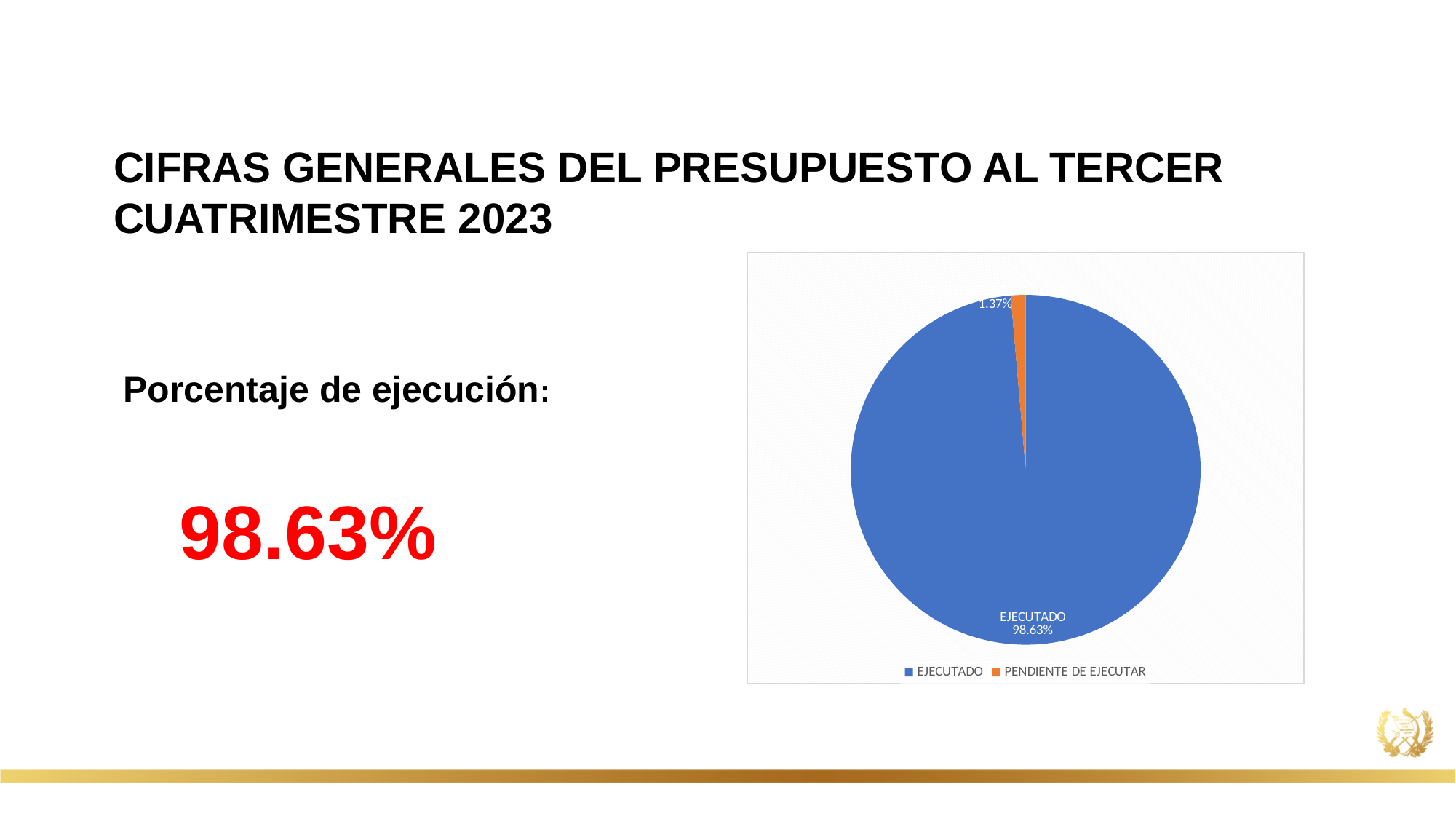
What colour is the PENDIENTE DE EJECUTAR slice? orange How many entries does the legend list? 2 What share of the pie does EJECUTADO represent? 98.63% What is the difference in percentage points between the EJECUTADO and PENDIENTE DE EJECUTAR slices? 97.26 Which slice of the pie is the smallest? PENDIENTE DE EJECUTAR What kind of chart is shown on the slide? pie chart Which is larger, the EJECUTADO slice or the PENDIENTE DE EJECUTAR slice? EJECUTADO How many slices does the pie chart have? 2 What share of the pie does PENDIENTE DE EJECUTAR represent? 1.37% What colour is the EJECUTADO slice? blue Which slice of the pie is the largest? EJECUTADO